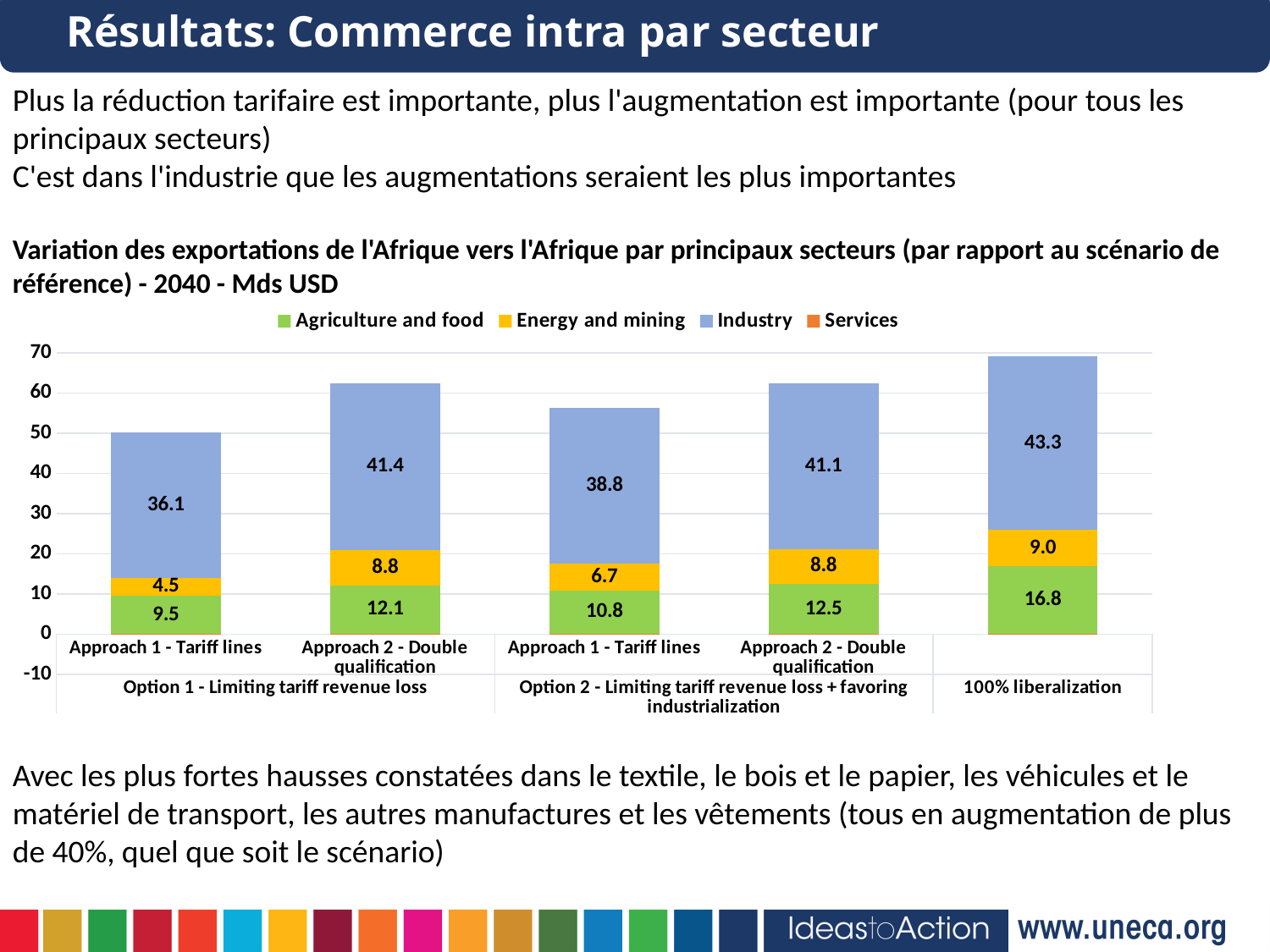
What kind of chart is shown on the slide? Stacked bar chart What is the difference between the Agriculture and food value for 100% liberalization and for Approach 1 - Tariff lines under Option 1? 7.3 Which has the larger Energy and mining value: Approach 1 - Tariff lines under Option 1 or Approach 1 - Tariff lines under Option 2? Approach 1 - Tariff lines under Option 2 How many bars are plotted in the chart? 5 What is the difference between the Industry value for 100% liberalization and the Industry value for Approach 1 - Tariff lines under Option 1? 7.2 Which scenario has the highest Industry value? 100% liberalization How many series does the legend list? 4 What is the Industry value for the 100% liberalization bar? 43.3 Is the total height of the 100% liberalization bar greater or less than 60? greater What is the Agriculture and food value for Approach 2 - Double qualification under Option 2 - Limiting tariff revenue loss + favoring industrialization? 12.5 What is the Energy and mining value for Approach 1 - Tariff lines under Option 1 - Limiting tariff revenue loss? 4.5 Which scenario has the lowest Agriculture and food value? Approach 1 - Tariff lines under Option 1 - Limiting tariff revenue loss